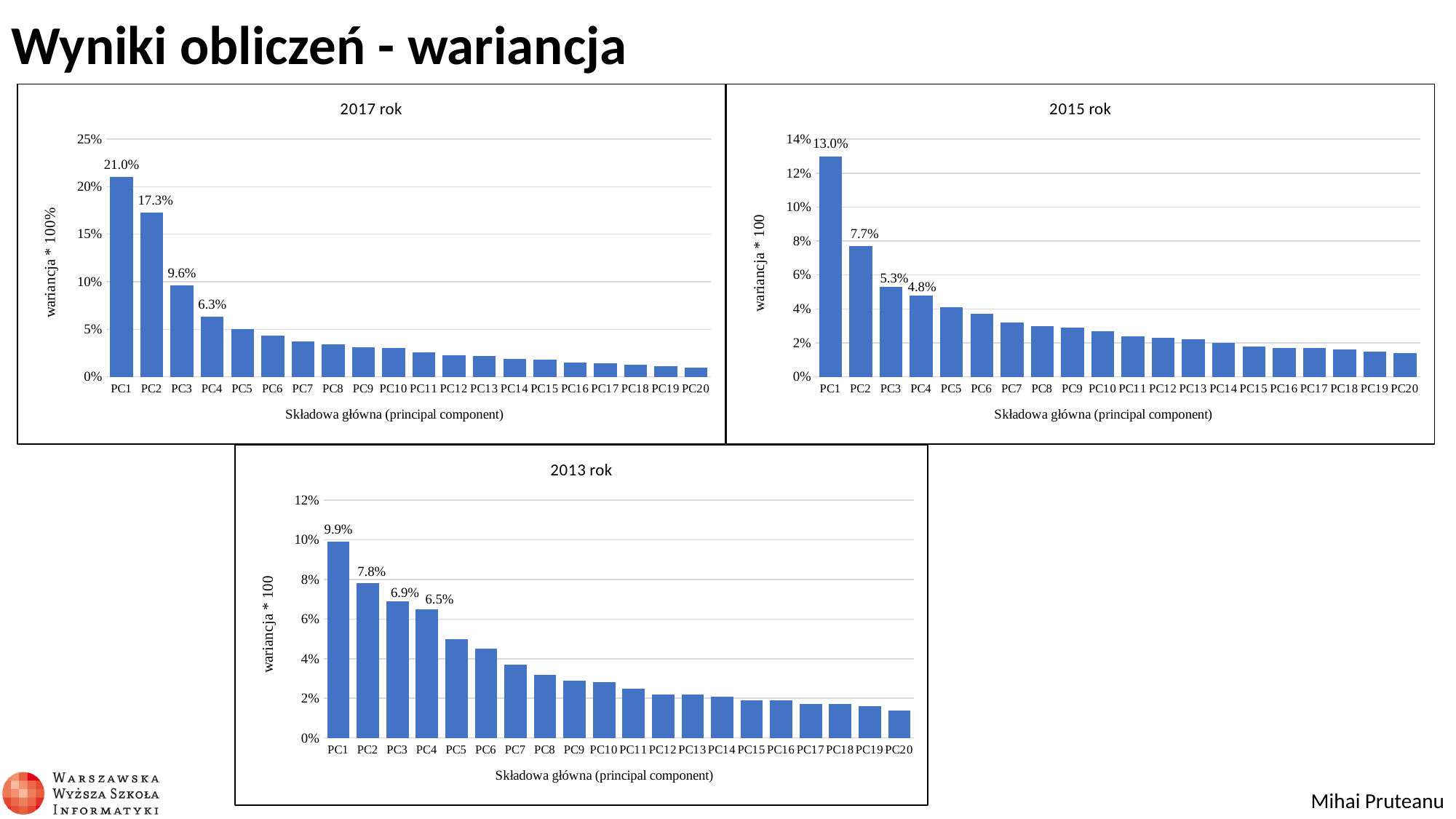
In the "2015 rok" chart, what is the value for PC2? 7.7% In the "2015 rok" chart, which principal component has the highest variance? PC1 In the "2013 rok" chart, which principal component has the lowest variance? PC20 In the "2017 rok" chart, what is the difference between the values for PC1 and PC2? 3.7% In the "2013 rok" chart, is the value for PC5 greater or less than 4%? greater In the "2013 rok" chart, what is the value for PC4? 6.5% In the "2017 rok" chart, what is the value for PC1? 21.0% What kind of chart is the "2013 rok" chart? bar chart In the "2017 rok" chart, what is the value for PC3? 9.6% In the "2015 rok" chart, what is the difference between the values for PC3 and PC4? 0.5% Which is larger: the value for PC1 in the "2015 rok" chart or the value for PC1 in the "2013 rok" chart? PC1 in the 2015 rok chart How many principal components are shown on the x axis of the "2017 rok" chart? 20